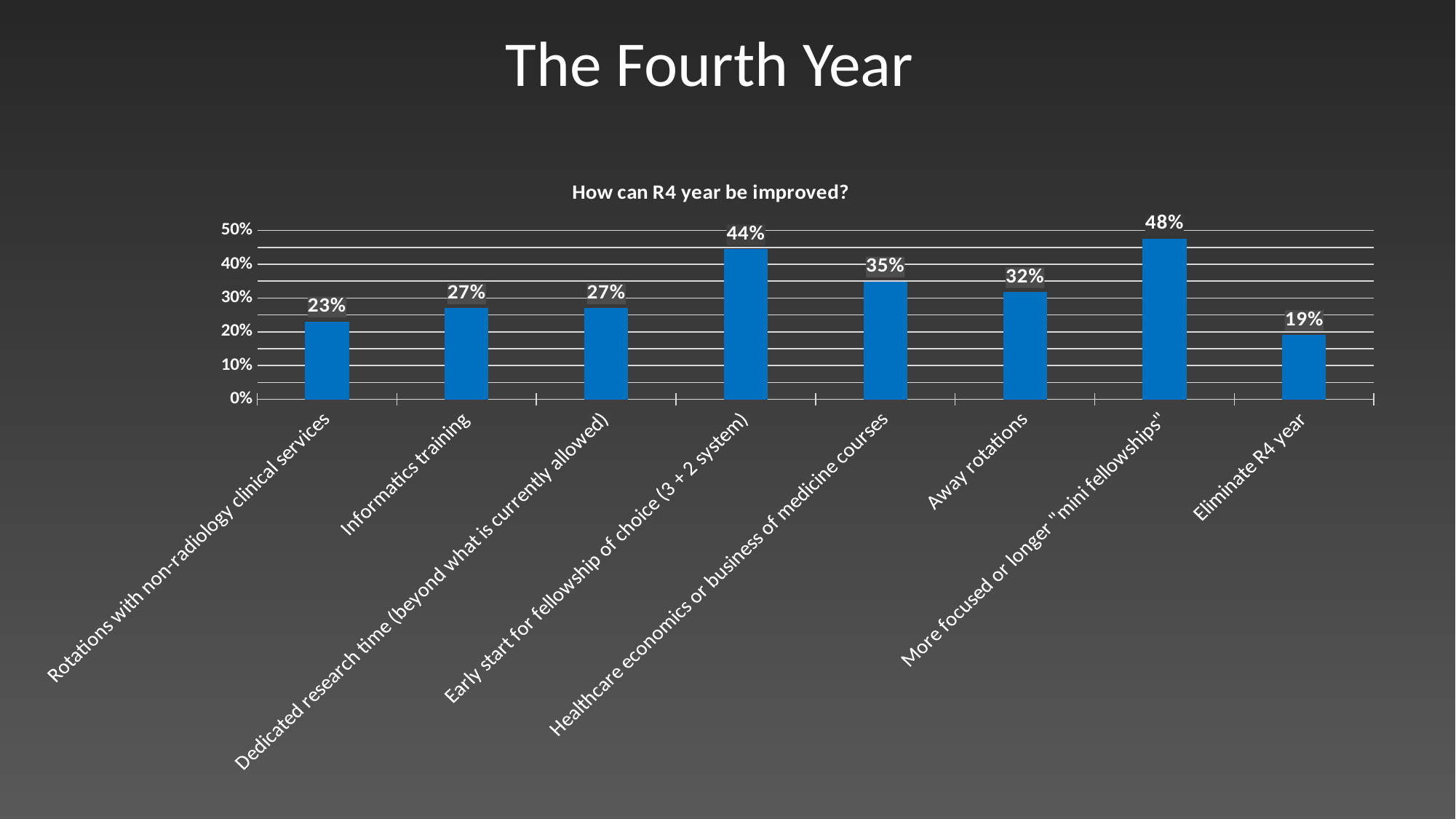
Which is larger, the value for "Informatics training" or the value for "Rotations with non-radiology clinical services"? Informatics training What kind of chart is shown on the slide? Bar chart What is the difference between the values for "More focused or longer "mini fellowships"" and "Eliminate R4 year"? 29% Which category has the highest value? More focused or longer "mini fellowships" What is the title of the chart? How can R4 year be improved? What is the value for "Early start for fellowship of choice (3 + 2 system)"? 44% What is the value for "Away rotations"? 32% How many categories are shown in the chart? 8 Which category has the lowest value? Eliminate R4 year What is the value for "Eliminate R4 year"? 19% What is the value for "Healthcare economics or business of medicine courses"? 35% Is the value for "Healthcare economics or business of medicine courses" greater or less than 30%? greater